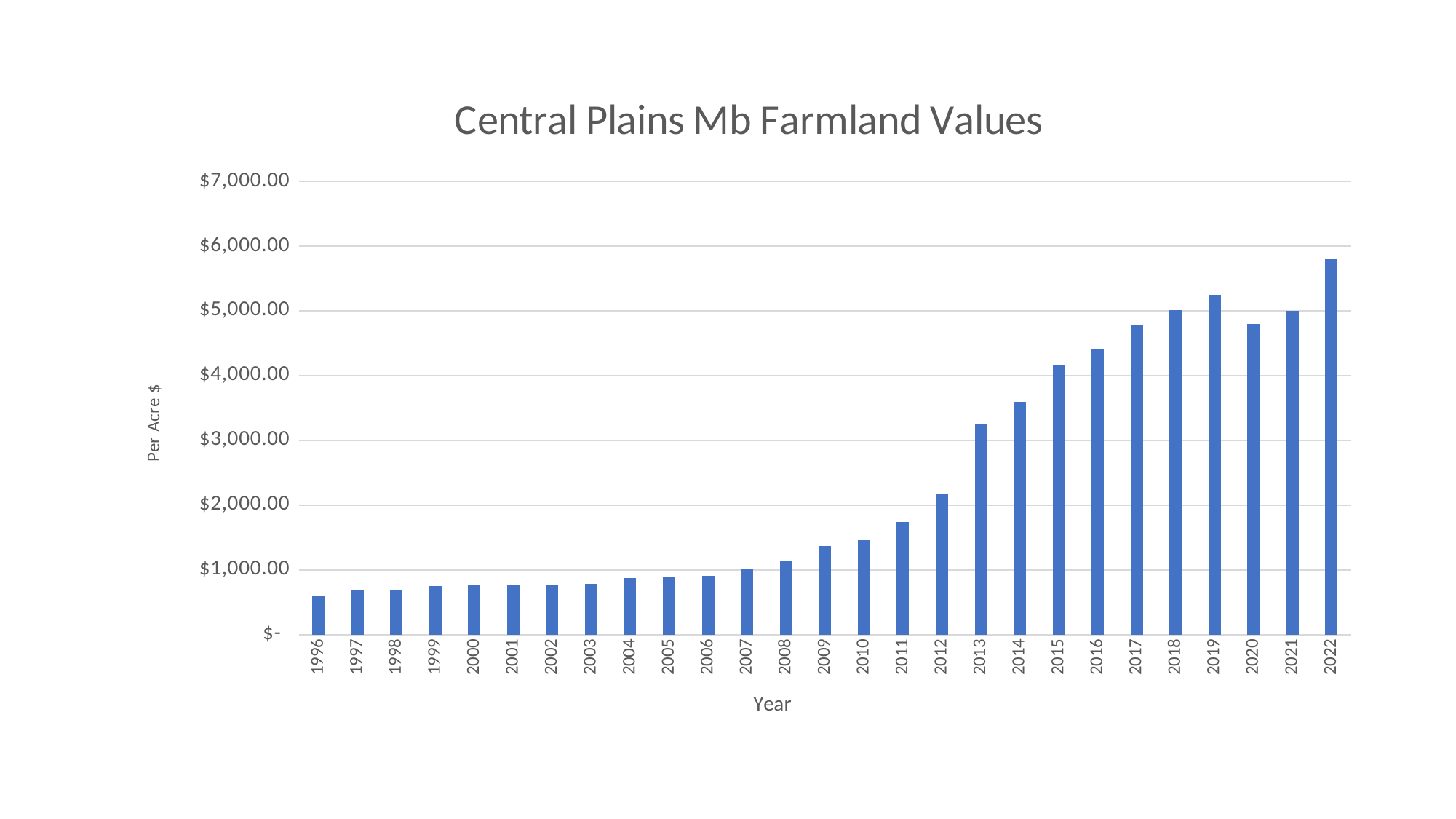
Is the value for 2013 greater or less than $3,000.00? greater Is the value for 2022 greater or less than $6,000.00? less Do farmland values generally rise or fall from 1996 to 2022? Rise What is the title of the chart? Central Plains Mb Farmland Values Which year has the highest farmland value? 2022 Is the value for 2020 greater or less than $5,000.00? less Which year has the larger value, 2019 or 2020? 2019 How many years are plotted on the chart? 27 What is the label on the vertical axis? Per Acre $ What type of chart is shown on the slide? Bar chart Which year has the lowest farmland value? 1996